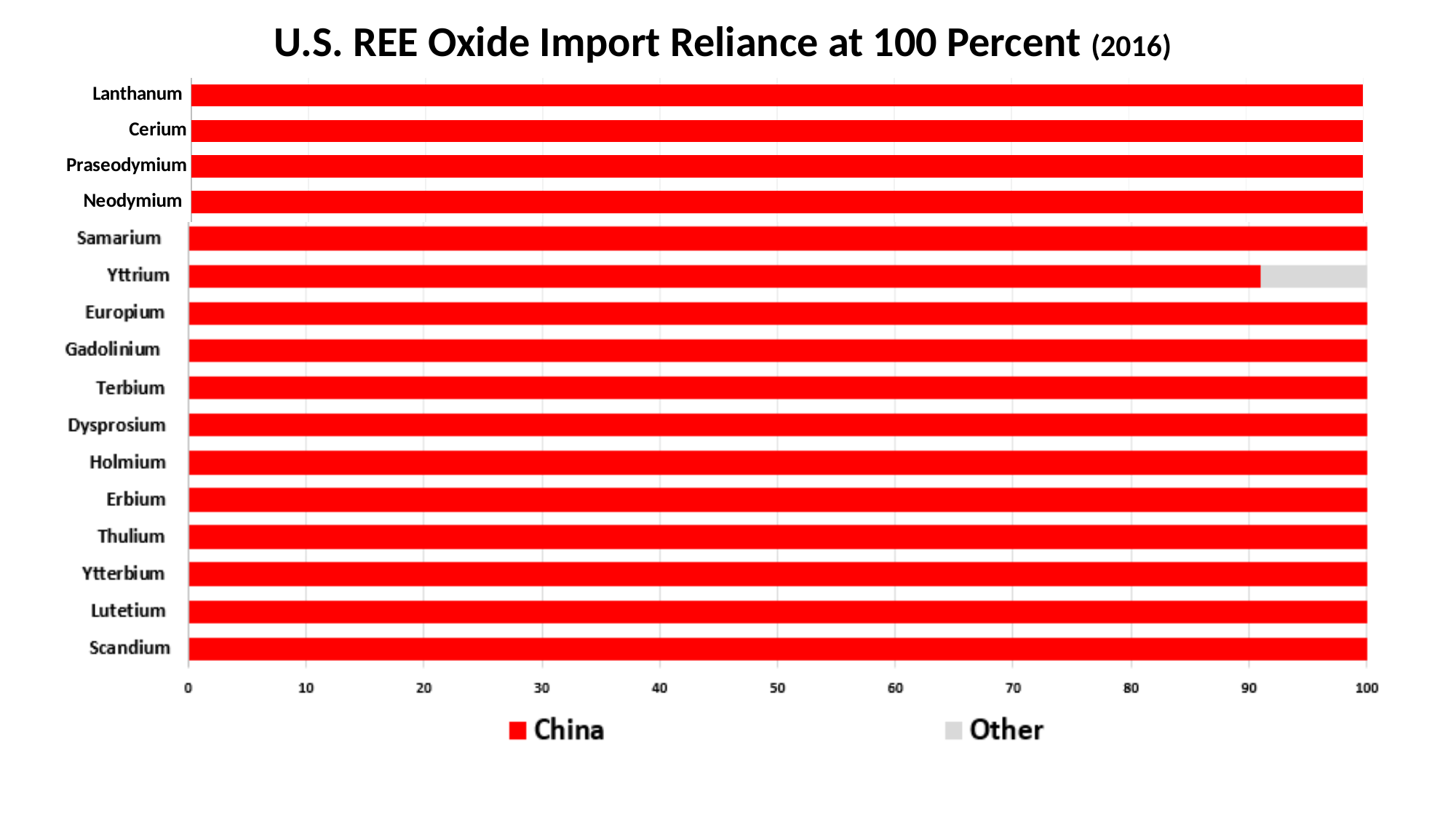
Which element is the only one with a visible 'Other' segment? Yttrium How many rare earth elements (categories) are plotted on the chart? 16 How many series does the legend list? 2 Is the Other value for Yttrium greater or less than 20? less What is the total value of the bar for Scandium? 100 What is the title of the chart? U.S. REE Oxide Import Reliance at 100 Percent (2016) Which is larger, the China value for Samarium or the China value for Yttrium? Samarium Which element has the lowest value for China? Yttrium What is the highest value shown on the horizontal axis? 100 What kind of chart is shown on the slide? bar chart Is the China value for Lanthanum greater or less than 90? greater Is the China value for Yttrium greater or less than 80? greater